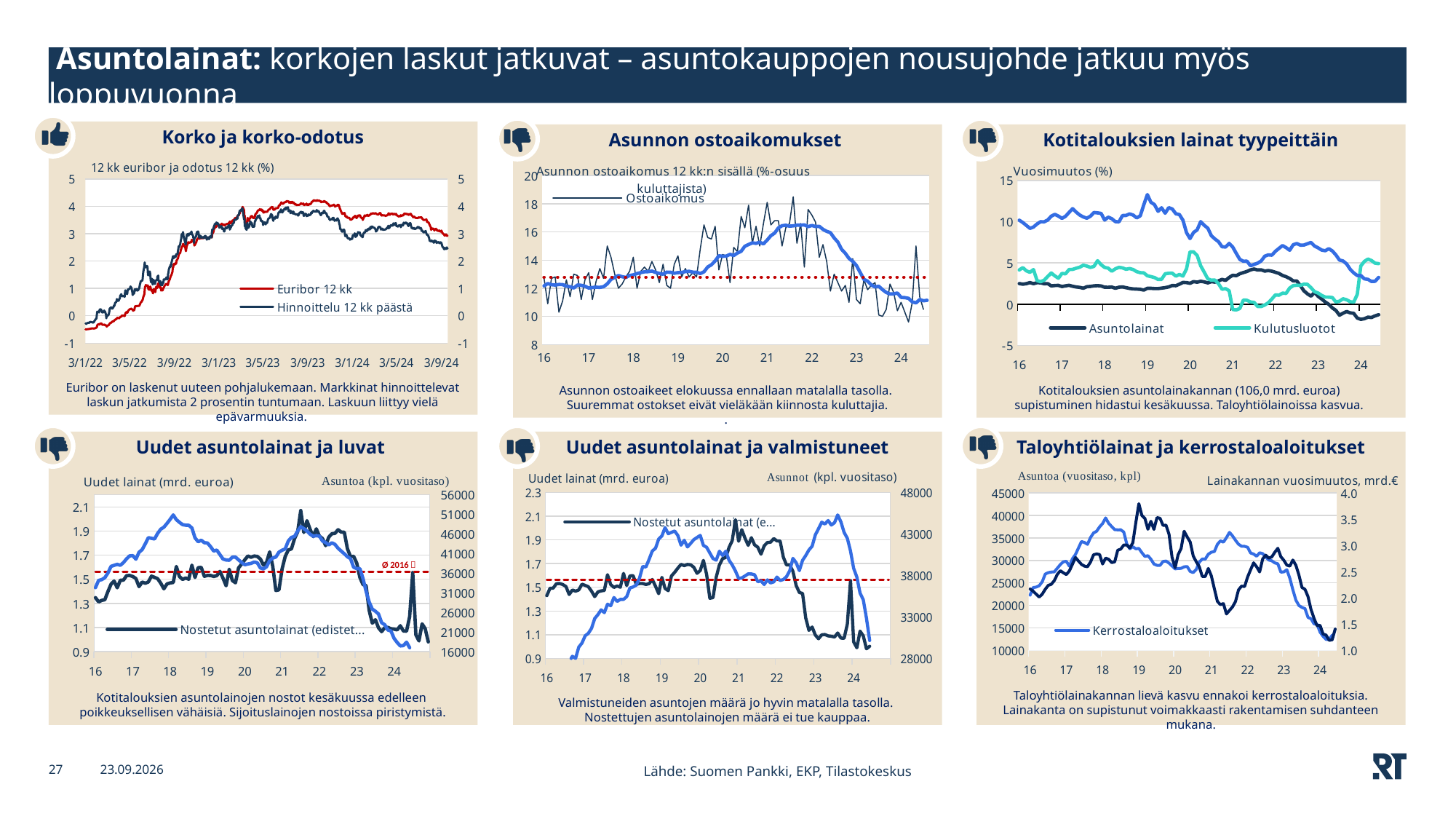
In the "Korko ja korko-odotus" chart, how many series does the legend list? 2 In the "Korko ja korko-odotus" chart, what are the two legend entries? Euribor 12 kk; Hinnoittelu 12 kk päästä In the "Taloyhtiölainat ja kerrostaloaloitukset" chart, is the Kerrostaloaloitukset value in 2024 greater or less than 20000? less In the "Kotitalouksien lainat tyypeittäin" chart, is the Asuntolainat value in 2024 greater or less than 0? less In the "Kotitalouksien lainat tyypeittäin" chart, is the Kulutusluotot value in 2019 greater or less than 10? less In the "Korko ja korko-odotus" chart, does the Euribor 12 kk line rise or fall between 3/1/22 and 3/9/23? rise In the "Taloyhtiölainat ja kerrostaloaloitukset" chart, does the Kerrostaloaloitukset line rise or fall between 2022 and 2024? fall What kind of chart is the "Korko ja korko-odotus" chart? line chart In the "Kotitalouksien lainat tyypeittäin" chart, which two series does the legend list? Asuntolainat; Kulutusluotot How many charts are shown on the slide? 6